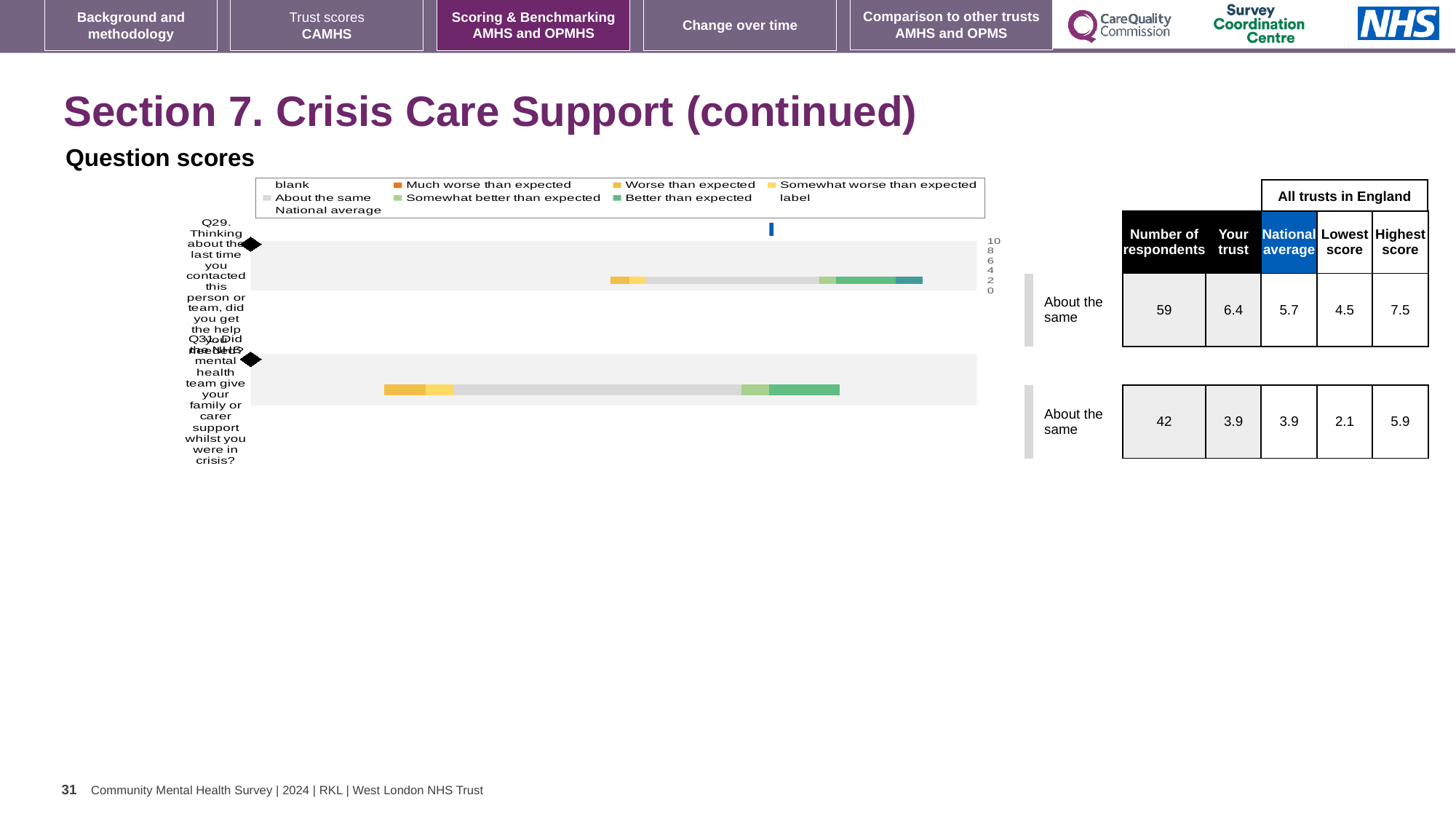
What is the 'Your trust' score for Q29 (Thinking about the last time you contacted this person or team, did you get the help you needed)? 6.4 How many questions (bars) are plotted in the question scores chart? 2 What is the highest score across all trusts in England for Q31? 5.9 How many respondents answered Q29? 59 Which question has the higher 'Your trust' score, Q29 or Q31? Q29 What is the lowest score across all trusts in England for Q29? 4.5 What is the difference between the 'Your trust' score and the national average for Q29? 0.7 What is the highest value shown on the chart's score axis? 10 How is the trust's performance categorised for Q31 relative to other trusts? About the same Which legend entry is shown in dark orange in the question scores chart? Much worse than expected What is the national average score for Q31 (Did the NHS mental health team give your family or carer support whilst you were in crisis)? 3.9 What kind of chart is used to show the question scores on this slide? bar chart